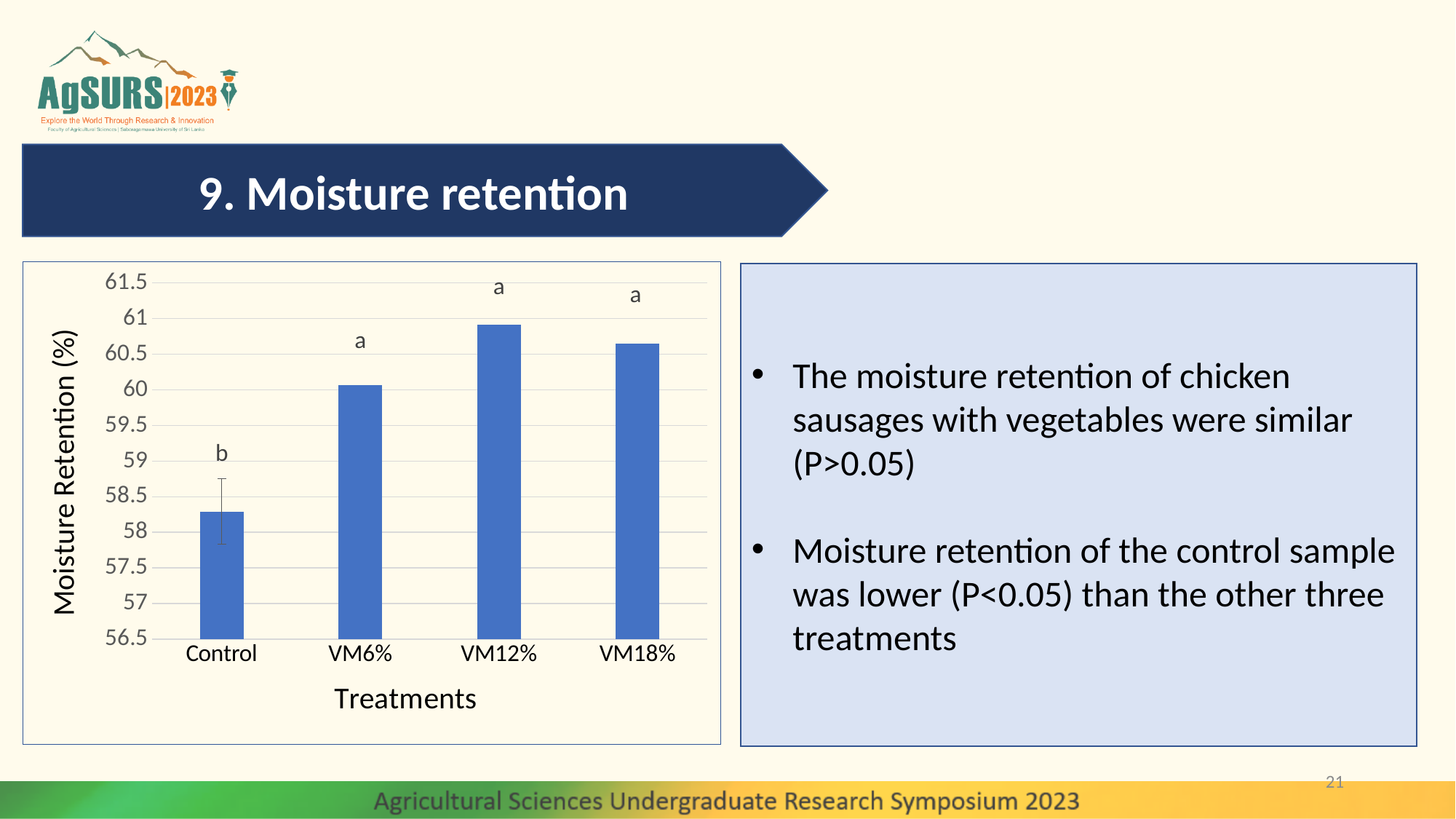
How many treatments are plotted on the x axis? 4 What is the title of the y axis? Moisture Retention (%) Is the moisture retention for Control greater or less than 58? greater Which has the higher moisture retention, Control or VM6%? VM6% Which treatment has the highest moisture retention? VM12% Which treatment has the lowest moisture retention? Control Is the moisture retention for VM12% greater or less than 61? less Is the moisture retention for Control greater or less than 59? less What letter is printed above the Control bar? b What kind of chart is shown on the slide? bar chart Which has the higher moisture retention, VM12% or VM18%? VM12%